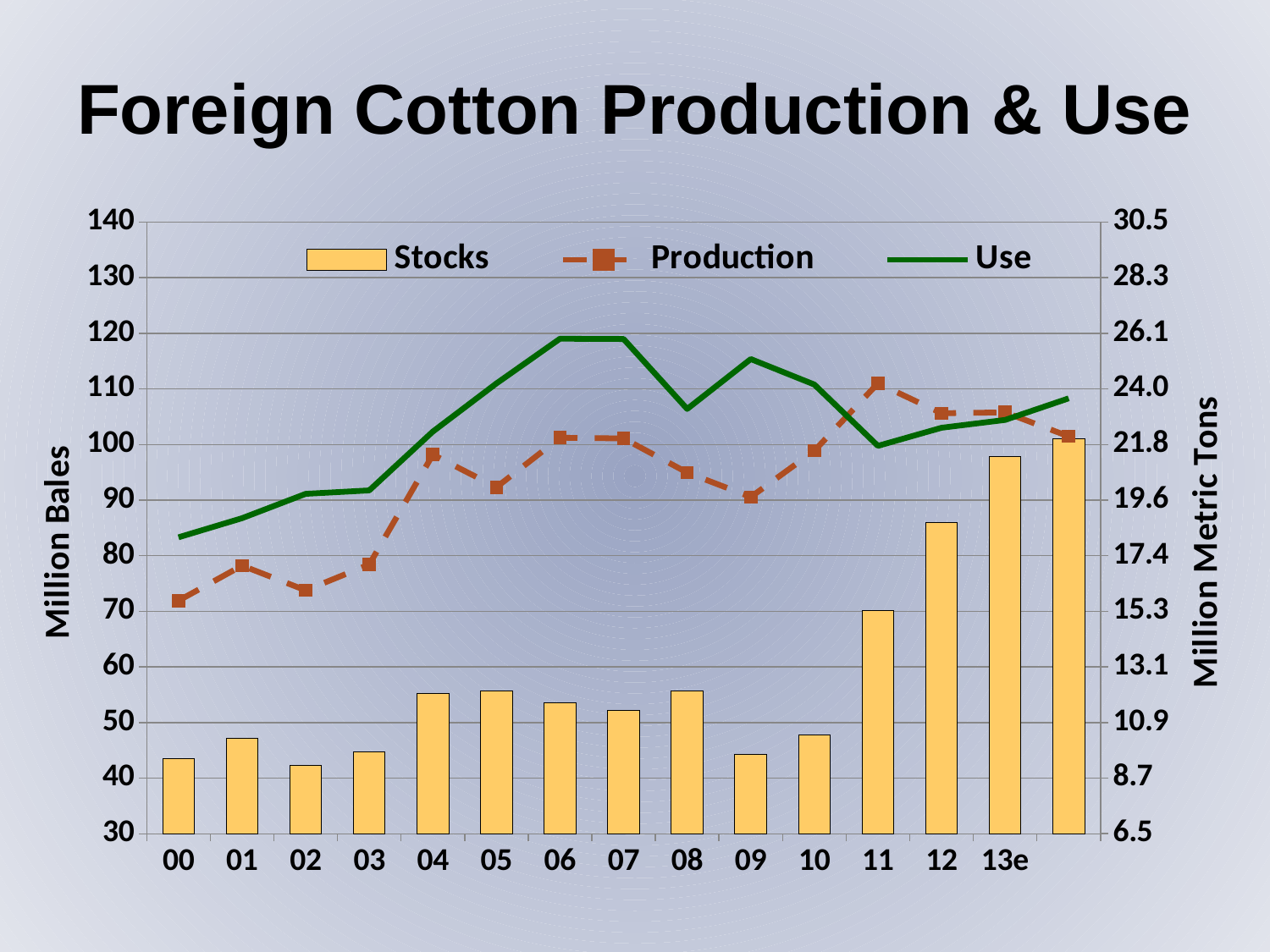
Which year has the highest Production value? 11 In 11, which is larger, Production or Use? Production Which year has the lowest Production value? 00 Is the Use value for 06 greater or less than 110 on the left axis? greater Is the Stocks value for 11 greater or less than 60 on the left axis? greater What is the label of the left vertical axis? Million Bales Do the Stocks values rise or fall from 10 to 13e? rise What is the title of the chart? Foreign Cotton Production & Use How many series does the legend list? 3 Is the Stocks value for 02 greater or less than 50 on the left axis? less What kind of chart is this? Combination bar and line chart